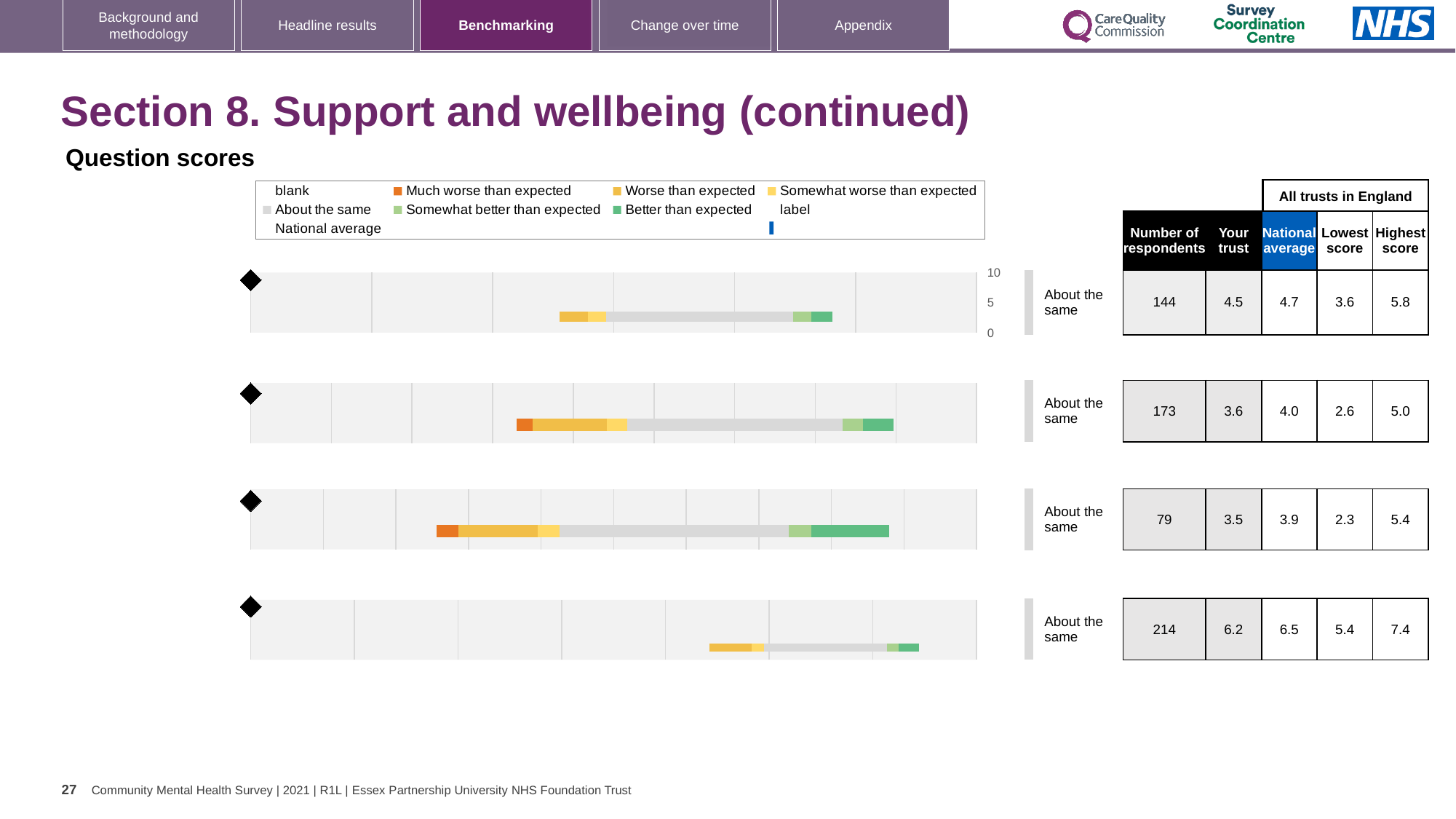
Which chart row has the largest number of respondents? the fourth (bottom) chart, 214 What benchmark category is shown next to each of the four charts? About the same How many question score charts are shown on the slide? 4 For the third chart from the top, what is the lowest score among all trusts in England? 2.3 For the first (top) chart, what is the 'Your trust' score? 4.5 What kind of chart is used for the question scores on this slide? bar chart For the fourth (bottom) chart, what is the highest score among all trusts in England? 7.4 For the first (top) chart, what is the number of respondents shown in the table? 144 For the second chart from the top, what is the national average score? 4.0 For the second chart from the top, which is larger: the 'Your trust' score or the national average? National average For the first (top) chart, what is the difference between the highest score and the lowest score? 2.2 Which chart row has the smallest number of respondents? the third chart, 79